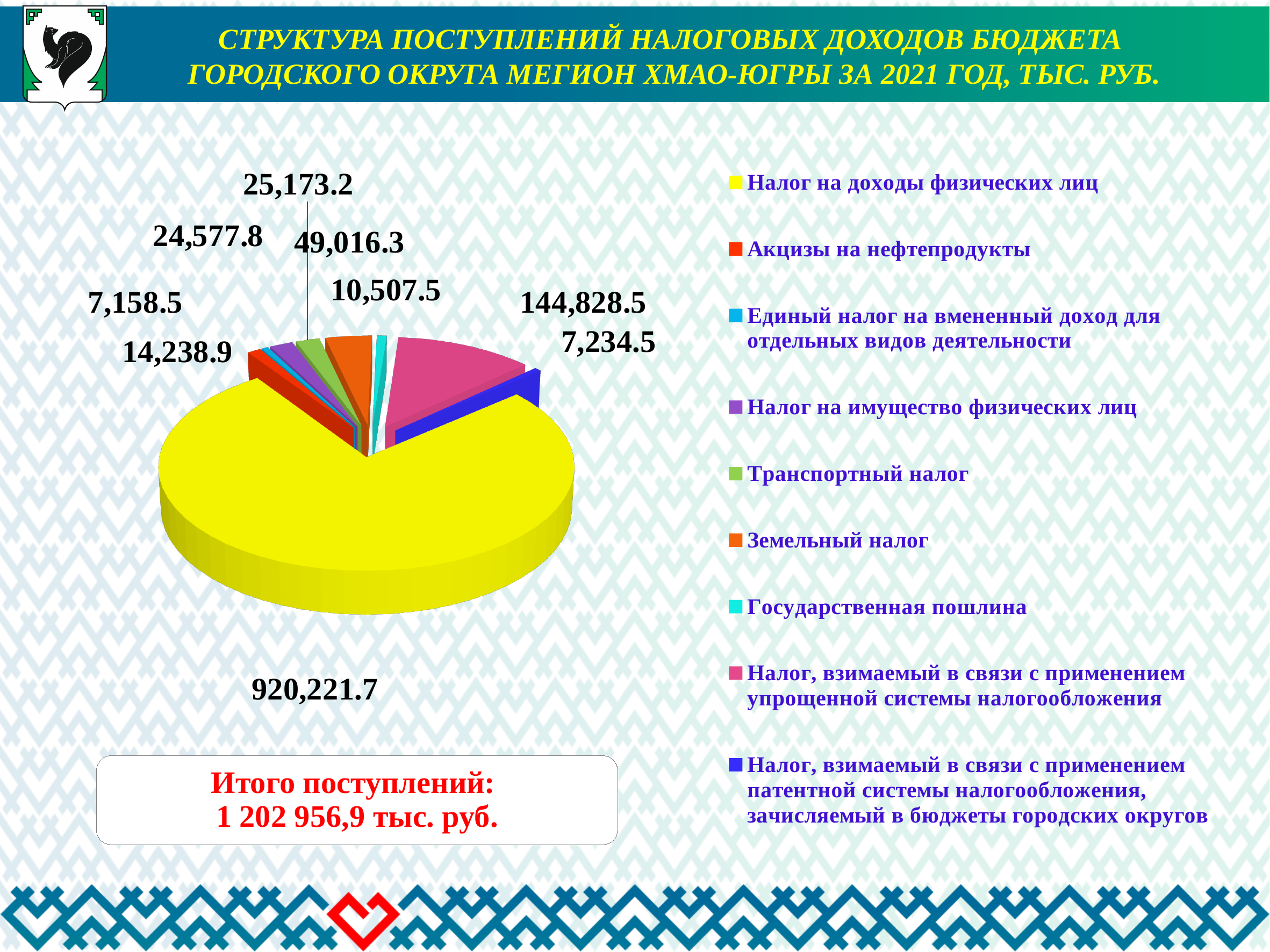
What is the value for Налог, взимаемый в связи с применением упрощенной системы налогообложения? 144,828.5 Which is larger: Земельный налог or Налог на имущество физических лиц? Земельный налог How many categories does the pie chart have? 9 What is the value for Налог на доходы физических лиц? 920,221.7 What is the value for Земельный налог? 49,016.3 What kind of chart is shown on the slide? pie chart What is the value for Государственная пошлина? 10,507.5 What total of receipts (Итого поступлений) is stated on the slide? 1 202 956,9 тыс. руб. What is the difference between Налог на доходы физических лиц and Налог, взимаемый в связи с применением упрощенной системы налогообложения? 775,393.2 Which category has the largest value in the pie chart? Налог на доходы физических лиц What is the value for Транспортный налог? 25,173.2 What colour is the slice for Налог на доходы физических лиц? yellow